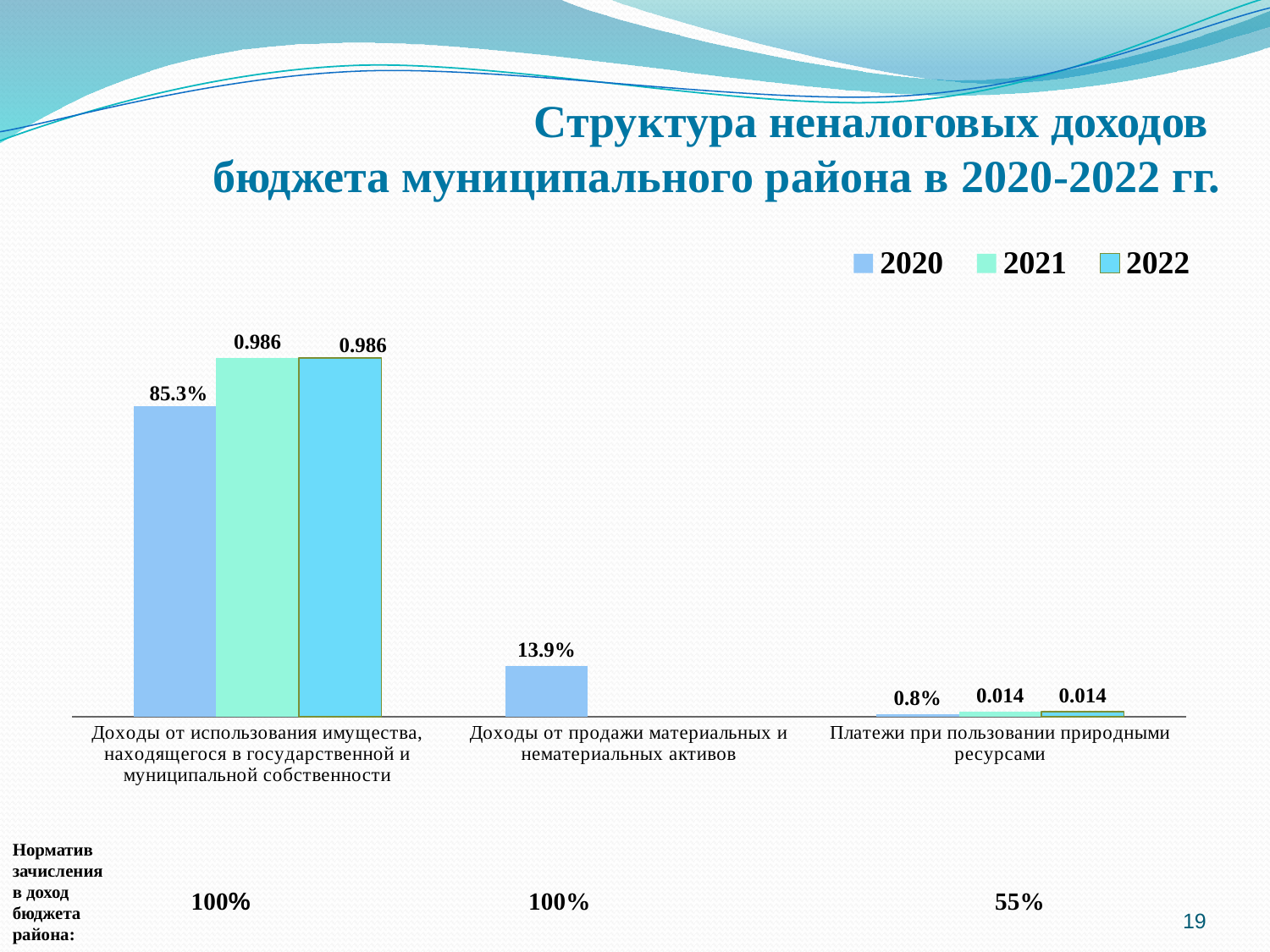
What is the 2021 value for "Доходы от использования имущества, находящегося в государственной и муниципальной собственности"? 0.986 What is the 2020 value for "Платежи при пользовании природными ресурсами"? 0.8% Which category has the lowest 2020 value? Платежи при пользовании природными ресурсами What is the difference between the 2020 values for "Доходы от использования имущества, находящегося в государственной и муниципальной собственности" and "Доходы от продажи материальных и нематериальных активов"? 71.4% What entries are listed in the chart legend? 2020, 2021, 2022 What is the 2022 value for "Платежи при пользовании природными ресурсами"? 0.014 What kind of chart is shown on the slide? bar chart What is the 2020 value for "Доходы от использования имущества, находящегося в государственной и муниципальной собственности"? 85.3% How many categories are shown on the x axis of the chart? 3 How many series does the legend list? 3 Which category has the highest 2020 value? Доходы от использования имущества, находящегося в государственной и муниципальной собственности What is the 2020 value for "Доходы от продажи материальных и нематериальных активов"? 13.9%